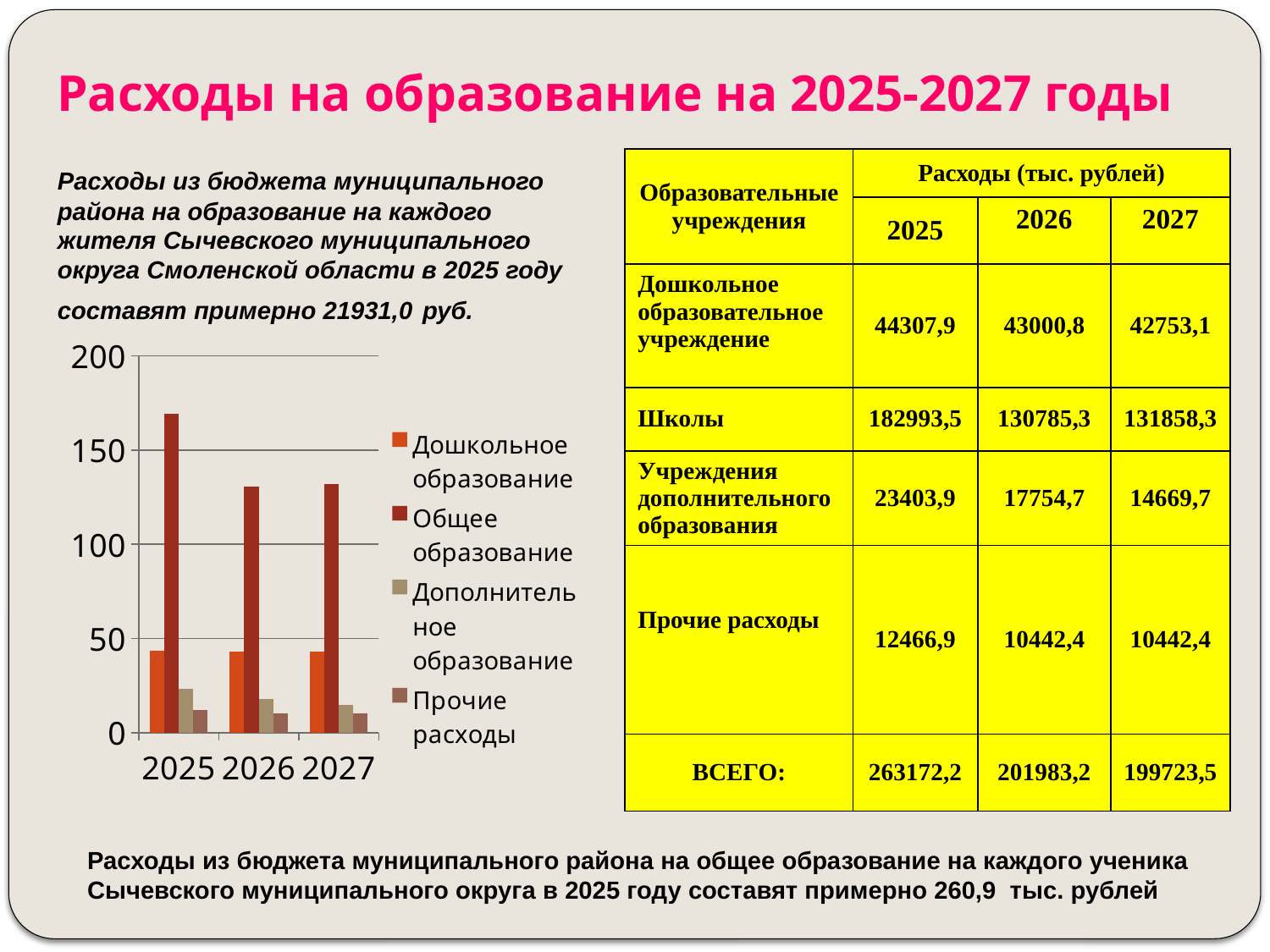
Which series has the shortest bar for 2025 in the chart? Прочие расходы Is the value for Общее образование in 2025 greater or less than 150? greater Is the value for Общее образование in 2026 greater or less than 100? greater Which is larger in the chart: Общее образование in 2025 or Общее образование in 2026? 2025 What is the highest tick value shown on the chart's vertical axis? 200 Is the value for Дошкольное образование in 2025 greater or less than 50? less What kind of chart is shown on the slide? bar chart Do the bars for Дополнительное образование rise or fall from 2025 to 2027? fall Which series has the tallest bar for 2025 in the chart? Общее образование How many series does the chart legend list? 4 Which legend entry is listed last in the chart legend? Прочие расходы How many years (categories) are shown on the x axis of the chart? 3